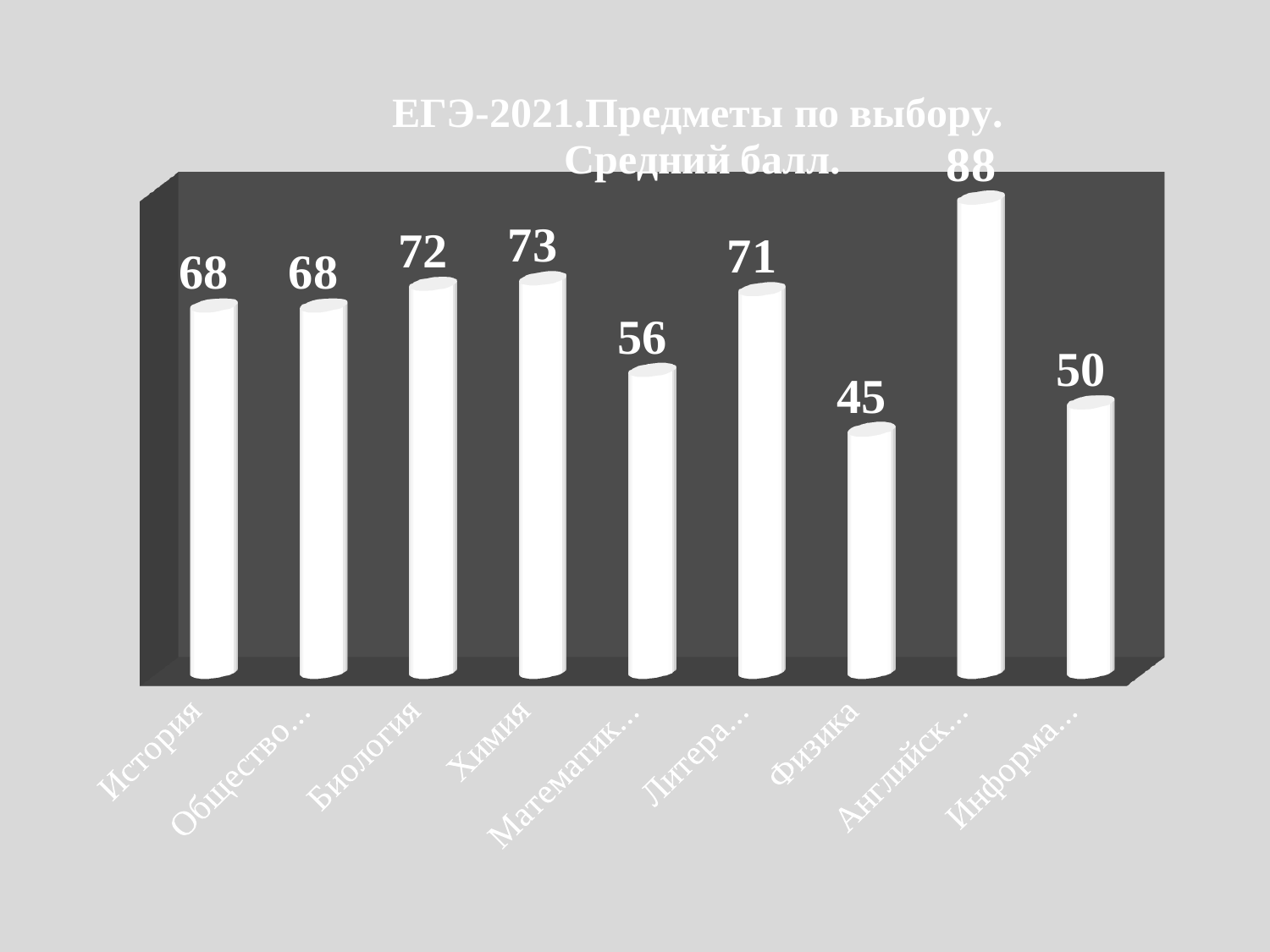
What kind of chart is shown on the slide? Bar chart Which subject has the lowest average score? Физика What is the title of the chart? ЕГЭ-2021.Предметы по выбору. Средний балл. What is the average score for Химия? 73 What is the difference between the average scores for Биология and Физика? 27 What is the average score for Биология? 72 What is the difference between the average scores for Химия and История? 5 What is the average score for История? 68 How many subjects are shown on the chart? 9 Which has a higher average score, Химия or Биология? Химия What is the average score for Физика? 45 What is the highest average score shown on the chart? 88